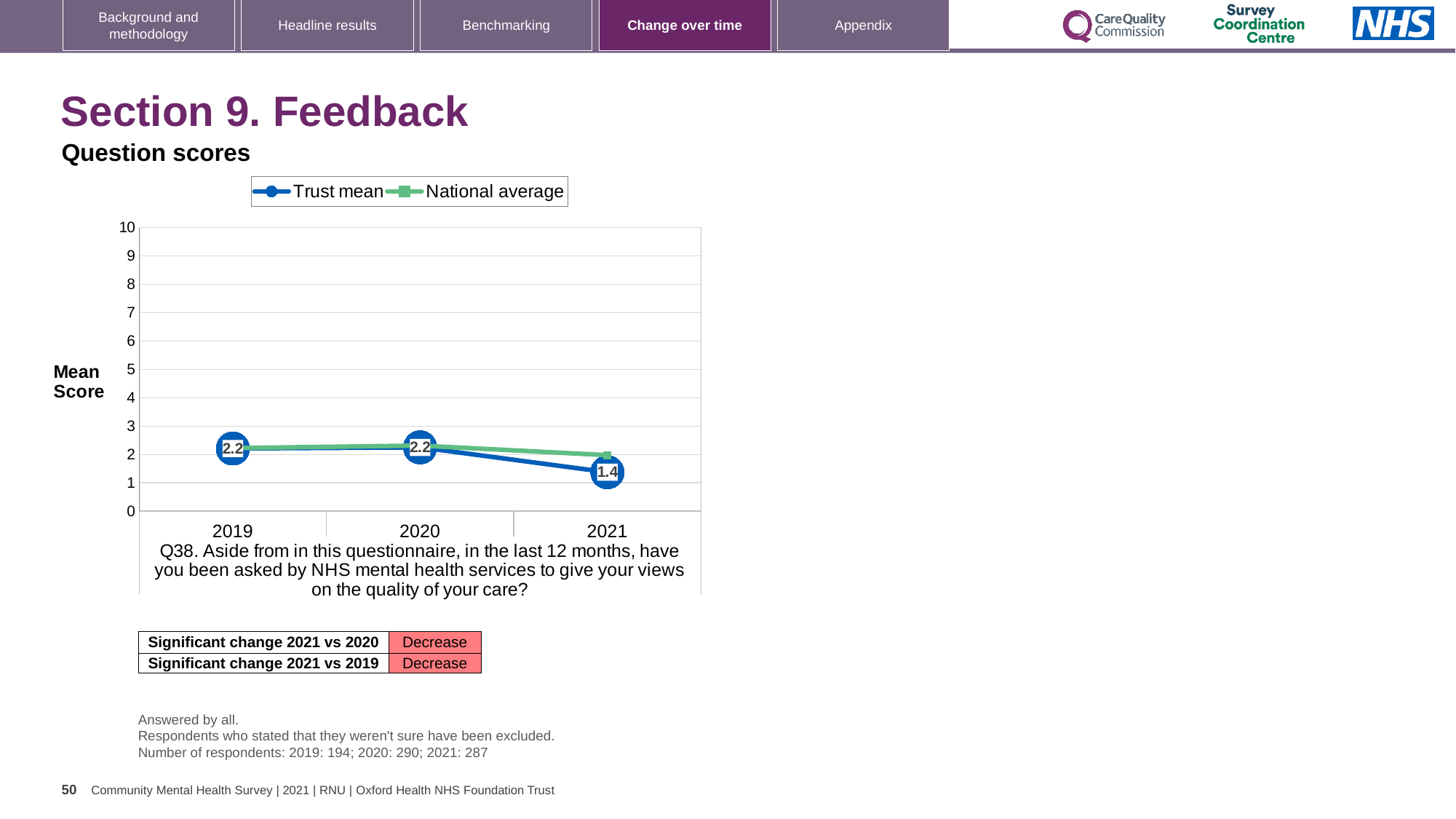
In which year is the Trust mean score lowest? 2021 By how much did the Trust mean score fall from 2020 to 2021? 0.8 What is the Trust mean score for 2021? 1.4 Is the National average for 2021 greater or less than 3? less Is the Trust mean for 2021 greater or less than 2? less In 2021, which is larger: the Trust mean or the National average? National average Does the Trust mean rise or fall between 2020 and 2021? Fall How many series does the legend list? 2 What kind of chart is shown on the slide? Line chart What is the Trust mean score for 2020? 2.2 How many years are plotted on the x axis? 3 What is the Trust mean score for 2019? 2.2